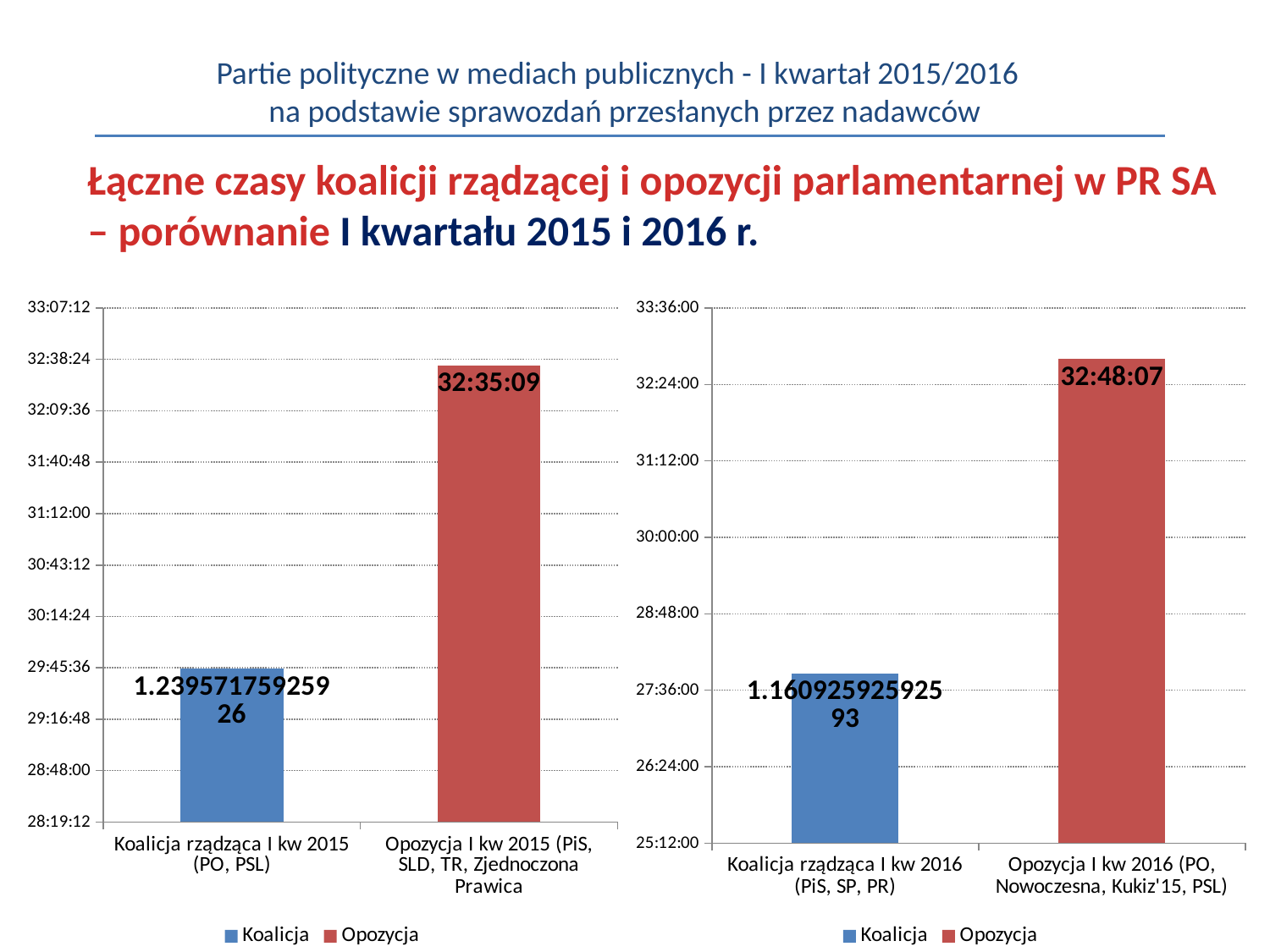
In the left chart (I kw 2015), which category has the highest bar? Opozycja I kw 2015 (PiS, SLD, TR, Zjednoczona Prawica) In the right chart (I kw 2016), what data label is printed on the bar for Koalicja rządząca I kw 2016 (PiS, SP, PR)? 1.16092592592593 In the left chart (I kw 2015), is the bar for Koalicja rządząca I kw 2015 (PO, PSL) greater or less than 30:14:24? less How many categories are plotted in the left chart (I kw 2015)? 2 What type of chart is the left chart (I kw 2015)? Bar chart In the right chart (I kw 2016), is the bar for Koalicja rządząca I kw 2016 (PiS, SP, PR) greater or less than 28:48:00? less In the right chart (I kw 2016), which category has the lowest bar? Koalicja rządząca I kw 2016 (PiS, SP, PR) In the right chart (I kw 2016), what is the value shown for Opozycja I kw 2016 (PO, Nowoczesna, Kukiz'15, PSL)? 32:48:07 In the left chart (I kw 2015), what data label is printed on the bar for Koalicja rządząca I kw 2015 (PO, PSL)? 1.23957175925926 In the left chart (I kw 2015), what is the value shown for Opozycja I kw 2015 (PiS, SLD, TR, Zjednoczona Prawica)? 32:35:09 How many series does the legend of the right chart (I kw 2016) list? 2 In the right chart (I kw 2016), which is larger: the bar for Koalicja rządząca or the bar for Opozycja? Opozycja